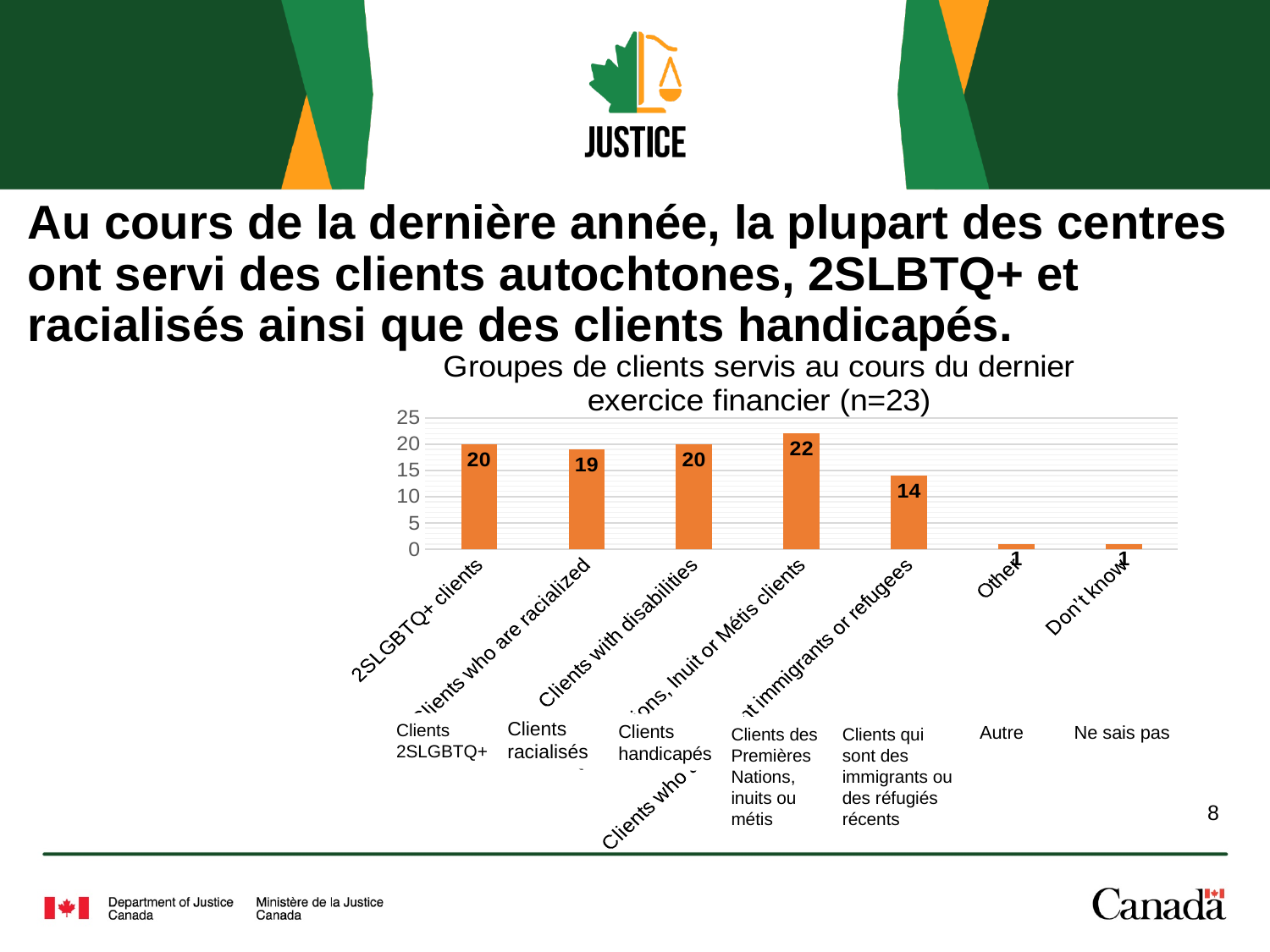
What is the difference between the values for Clients des Premières Nations, inuits ou métis and Clients qui sont des immigrants ou des réfugiés récents? 8 What kind of chart is shown on the slide? bar chart What is the value for Clients racialisés? 19 Which category has the highest value? Clients des Premières Nations, inuits ou métis How many categories are shown in the chart? 7 What is the value for Clients 2SLGBTQ+? 20 Is the value for Clients qui sont des immigrants ou des réfugiés récents greater or less than 15? less Which is larger, the value for Clients handicapés or the value for Clients racialisés? Clients handicapés What is the sample size (n) given in the chart title? n=23 What is the value for Clients qui sont des immigrants ou des réfugiés récents? 14 What is the value for Autre? 1 What is the value for Clients des Premières Nations, inuits ou métis? 22